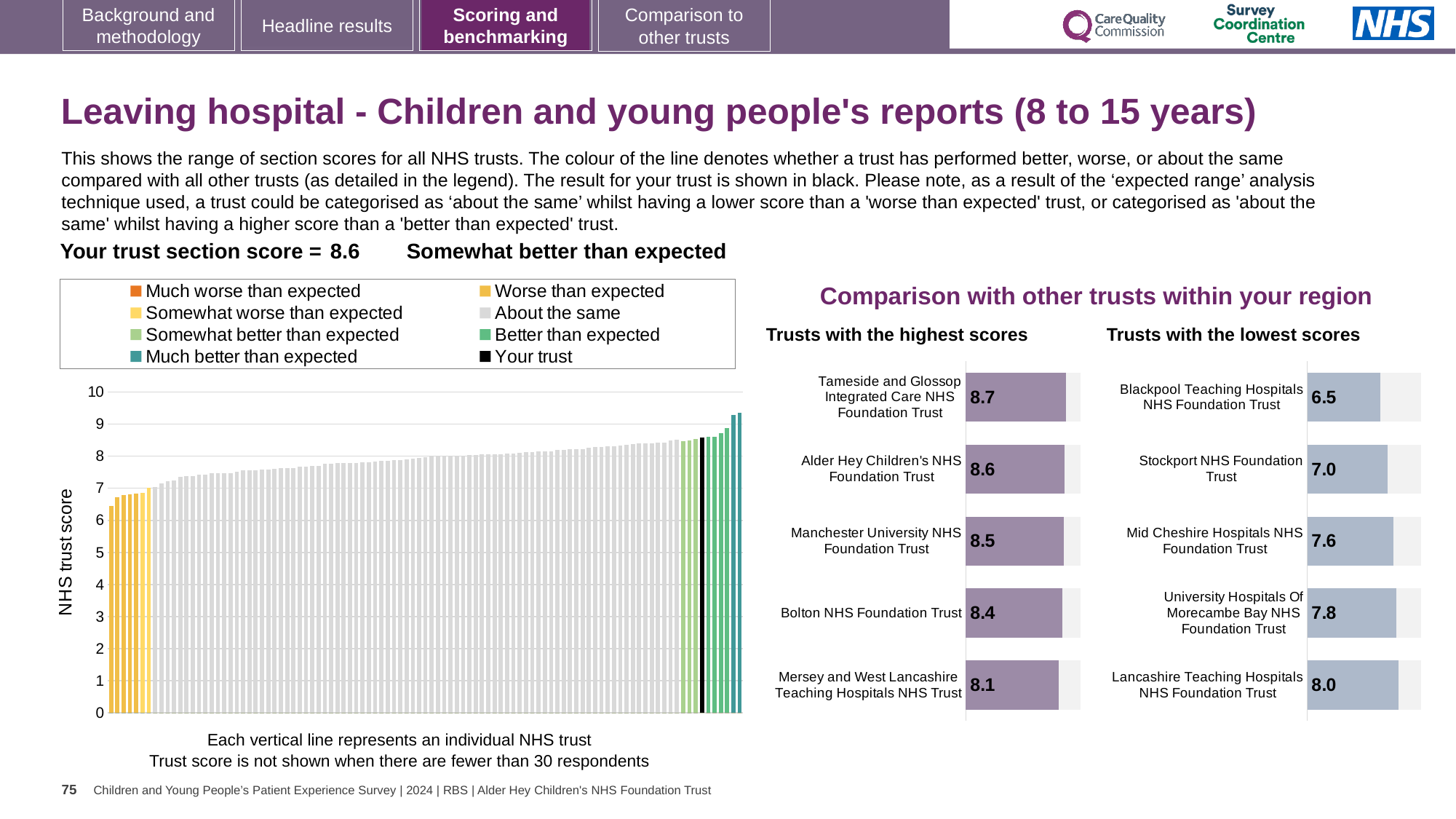
In the 'Trusts with the lowest scores' chart, what is the difference between the scores of Lancashire Teaching Hospitals NHS Foundation Trust and Blackpool Teaching Hospitals NHS Foundation Trust? 1.5 How many entries does the legend of the main 'NHS trust score' chart on the left list? 8 In the 'Trusts with the lowest scores' chart, which trust has the lowest score? Blackpool Teaching Hospitals NHS Foundation Trust In the 'Trusts with the highest scores' chart, what is the score for Tameside and Glossop Integrated Care NHS Foundation Trust? 8.7 In the 'Trusts with the highest scores' chart, which trust has the highest score? Tameside and Glossop Integrated Care NHS Foundation Trust In the main 'NHS trust score' chart on the left, what is the section score for your trust (shown in black)? 8.6 In the 'Trusts with the lowest scores' chart, what is the score for Stockport NHS Foundation Trust? 7.0 In the 'Trusts with the highest scores' chart, what is the score for Bolton NHS Foundation Trust? 8.4 In the main 'NHS trust score' chart on the left, do the trust scores rise or fall from left to right? rise In the 'Trusts with the highest scores' chart, what is the difference between the scores of Tameside and Glossop Integrated Care NHS Foundation Trust and Mersey and West Lancashire Teaching Hospitals NHS Trust? 0.6 How many trusts are listed in the 'Trusts with the highest scores' chart? 5 In the 'Trusts with the lowest scores' chart, which has the higher score: Mid Cheshire Hospitals NHS Foundation Trust or University Hospitals Of Morecambe Bay NHS Foundation Trust? University Hospitals Of Morecambe Bay NHS Foundation Trust